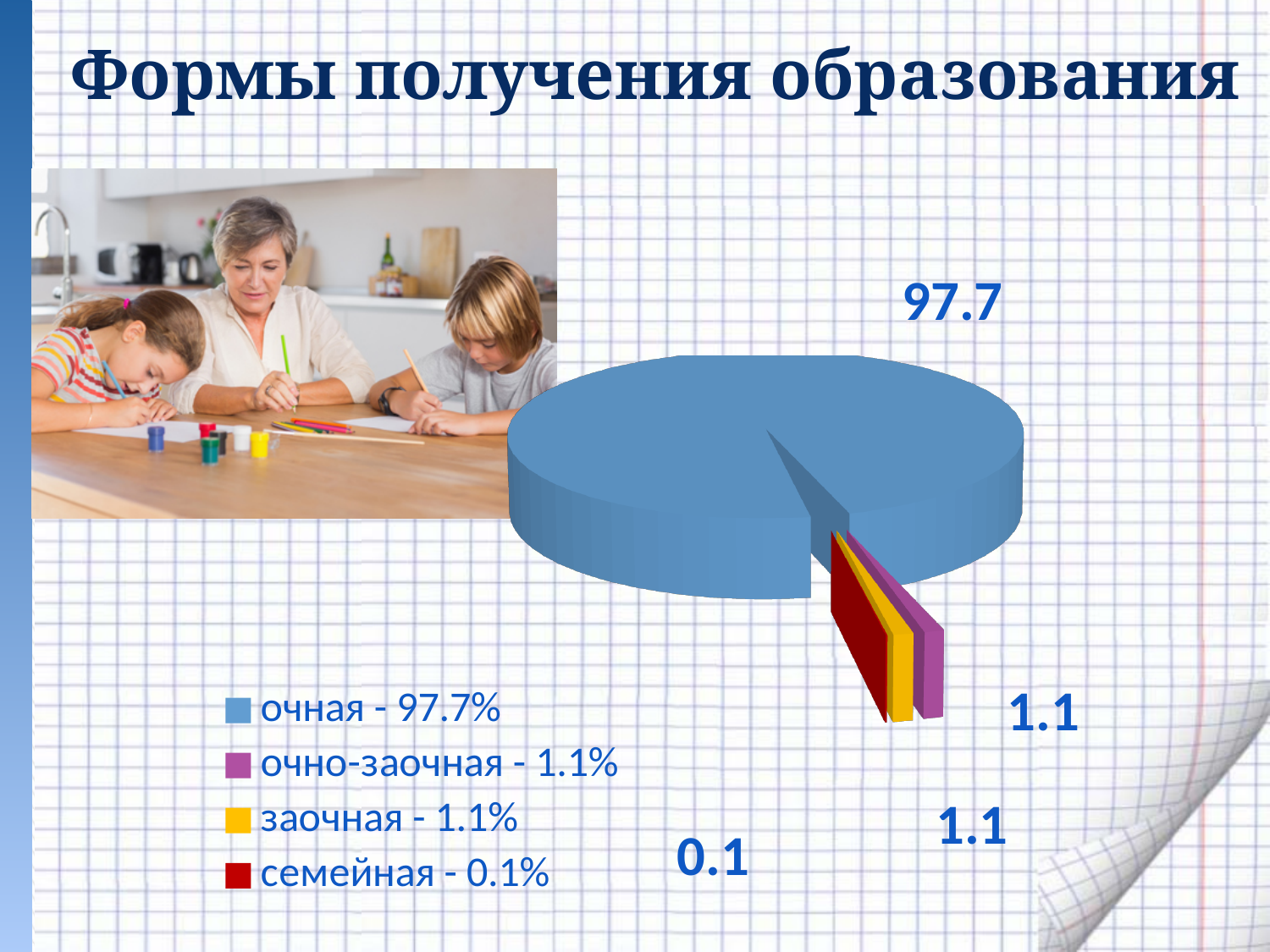
What share of the pie does очная represent according to the legend? 97.7% Which category has the smallest slice of the pie? семейная What is the difference between the values for очно-заочная and семейная? 1.0 How many categories does the pie chart have? 4 What is the value shown for the семейная slice? 0.1 What colour is the семейная slice? red What is the difference between the values for очная and семейная? 97.6 What is the value shown for the очная slice? 97.7 Which category has the largest slice of the pie? очная Which is larger, the value for очная or the value for семейная? очная What is the value shown for the заочная slice? 1.1 What kind of chart is shown on the slide? pie chart